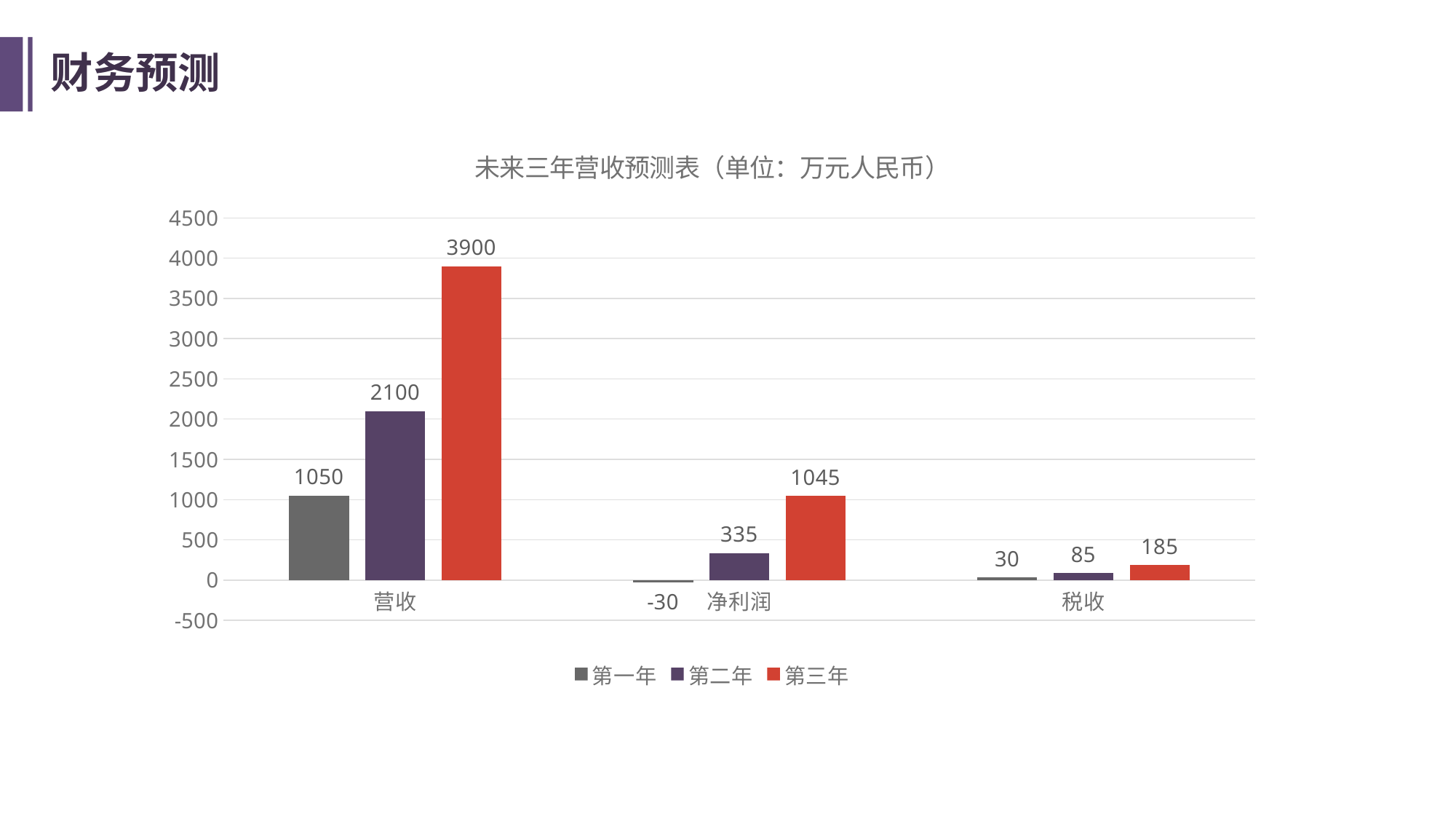
Which series has the lowest value in the 净利润 category? 第一年 What kind of chart is shown on the slide? Bar chart What is the title of the chart? 未来三年营收预测表（单位：万元人民币） What is the value for 第二年 in the 税收 category? 85 Which is larger: the 第二年 value for 净利润 or the 第三年 value for 税收? 第二年 value for 净利润 What is the difference between the 第三年 and 第一年 values for 税收? 155 How many categories are shown on the x axis? 3 Which series has the highest value in the 营收 category? 第三年 What is the value for 第三年 in the 营收 category? 3900 What is the difference between the 第三年 and 第二年 values for 营收? 1800 How many series does the legend list? 3 What is the value for 第一年 in the 净利润 category? -30